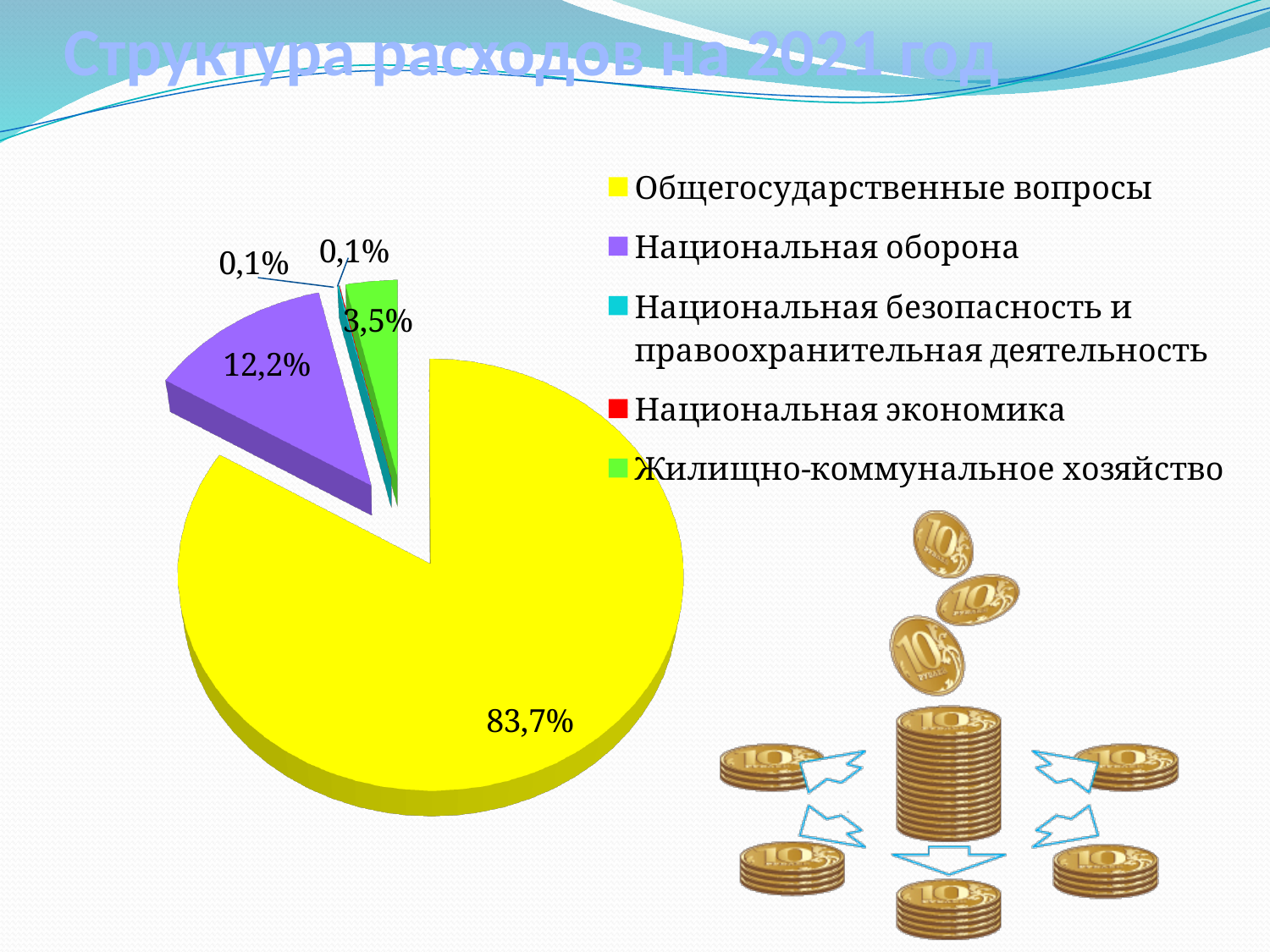
What share of the pie does Общегосударственные вопросы take? 83,7% What kind of chart is shown on the slide? pie chart What colour is the slice for Национальная оборона? purple What is the value shown for Национальная экономика? 0,1% Which category has the largest share of the pie? Общегосударственные вопросы How many categories does the legend of the pie chart list? 5 What is the value shown for Национальная безопасность и правоохранительная деятельность? 0,1% Which is larger, the share of Национальная оборона or the share of Жилищно-коммунальное хозяйство? Национальная оборона What is the value shown for Национальная оборона? 12,2% What is the title of the slide? Структура расходов на 2021 год What is the difference between the shares of Общегосударственные вопросы and Национальная оборона? 71,5% What is the value shown for Жилищно-коммунальное хозяйство? 3,5%